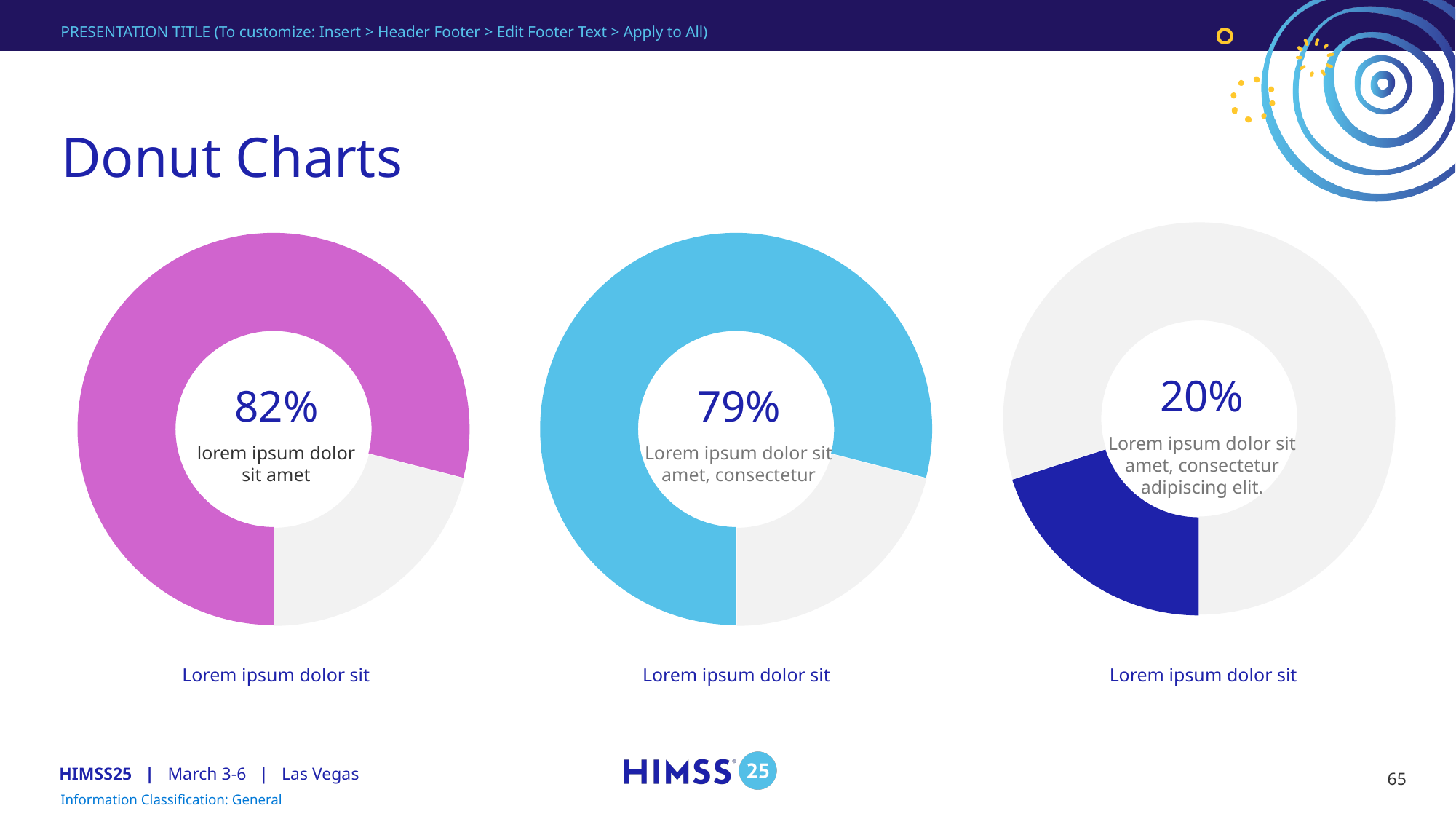
What colour is the filled segment of the middle donut chart? light blue What is the difference between the percentage in the left donut chart and the percentage in the middle donut chart? 3% What percentage is shown in the centre of the left donut chart? 82% What percentage is shown in the centre of the middle donut chart? 79% Which donut chart shows the highest percentage: left, middle or right? left What kind of chart is used on this slide? donut chart What is the difference between the percentage in the middle donut chart and the percentage in the right donut chart? 59% What is the title of the slide? Donut Charts What percentage is shown in the centre of the right donut chart? 20% Which donut chart shows the lowest percentage: left, middle or right? right Which is larger, the percentage in the left donut chart or the percentage in the right donut chart? left How many donut charts are on the slide? 3